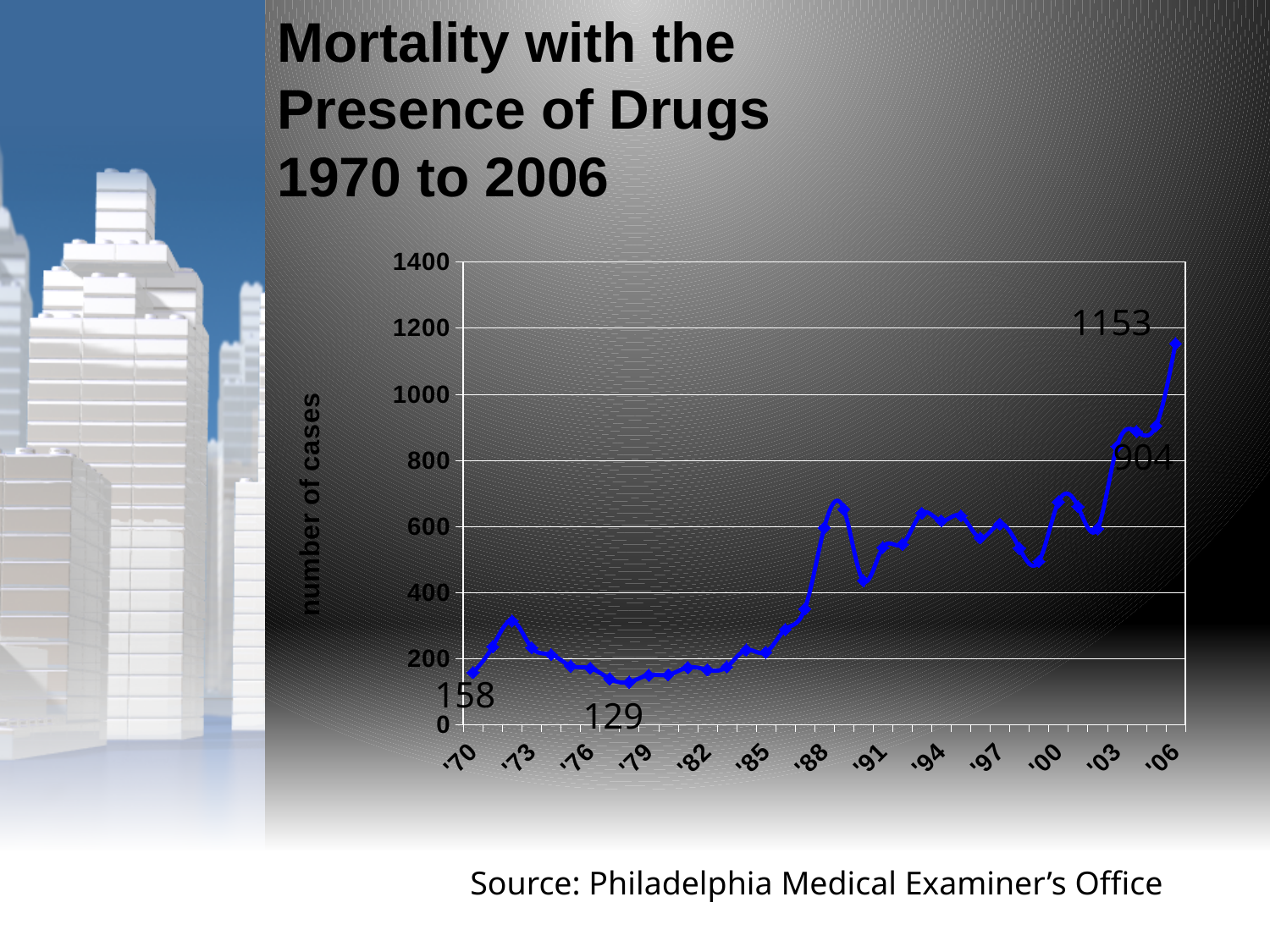
What is the lowest value labeled on the chart? 129 Does the number of cases rise or fall from '03 to '06? rise Which year has the highest number of cases? '06 Is the value for '97 greater or less than 400? greater Is the value for '82 greater or less than 400? less What is the difference between the labeled values 1153 and 904? 249 What is the number of cases for '70? 158 What is the difference between the number of cases in '06 and in '70? 995 Which is larger, the number of cases in '70 or in '06? '06 What kind of chart is shown on the slide? line chart What is the number of cases for '06? 1153 What is the label on the vertical axis? number of cases